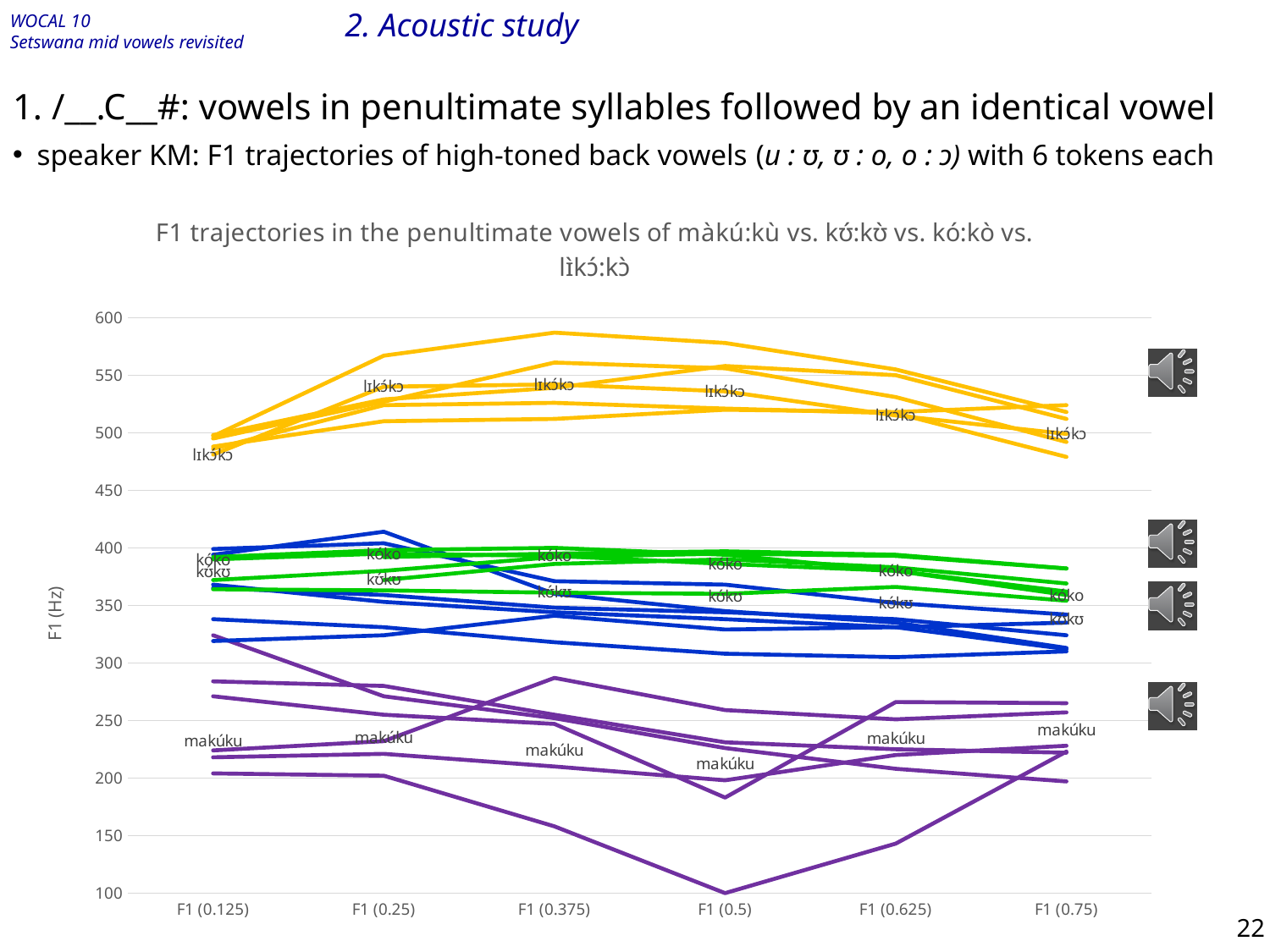
How many time points are shown along the x axis of the chart? 6 Are the F1 values for kʊ́kʊ at F1 (0.75) greater or less than 400? less Which word's F1 trajectories lie lowest on the chart? màkú:kù Which has higher F1 values at F1 (0.5): the kóko trajectories or the makúku trajectories? kóko Are the F1 values for lɪkɔ́kɔ at F1 (0.375) greater or less than 500? greater Are the F1 values for makúku at F1 (0.5) greater or less than 300? less Which word's F1 trajectories lie highest on the chart? lɪ̀kɔ́:kɔ̀ What is the label of the y axis of the chart? F1 (Hz) Which has higher F1 values at F1 (0.375): the lɪkɔ́kɔ trajectories or the kʊ́kʊ trajectories? lɪkɔ́kɔ What colour are the lines for the word makúku on the chart? purple What kind of chart is shown on the slide? line chart